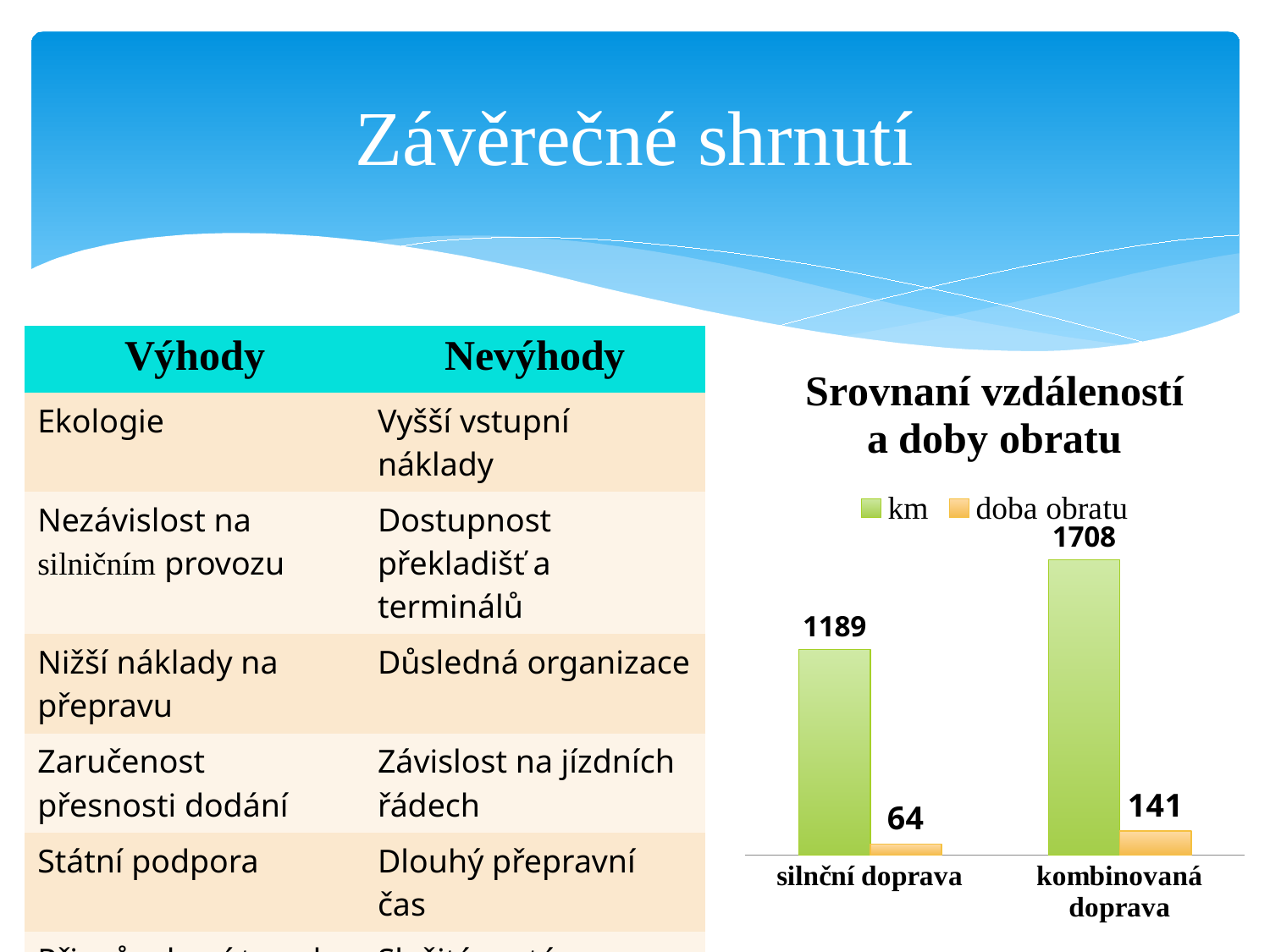
Is the doba obratu value larger for silnční doprava or kombinovaná doprava? kombinovaná doprava What is the doba obratu value for silnční doprava? 64 Which category has the lower doba obratu value? silnční doprava What is the difference in km between kombinovaná doprava and silnční doprava? 519 What is the km value for kombinovaná doprava? 1708 How many categories are shown on the x axis of the chart? 2 What is the km value for silnční doprava? 1189 What is the difference in doba obratu between kombinovaná doprava and silnční doprava? 77 How many series does the chart legend list? 2 What is the title of the chart? Srovnaní vzdáleností a doby obratu Which category has the higher km value? kombinovaná doprava What is the doba obratu value for kombinovaná doprava? 141